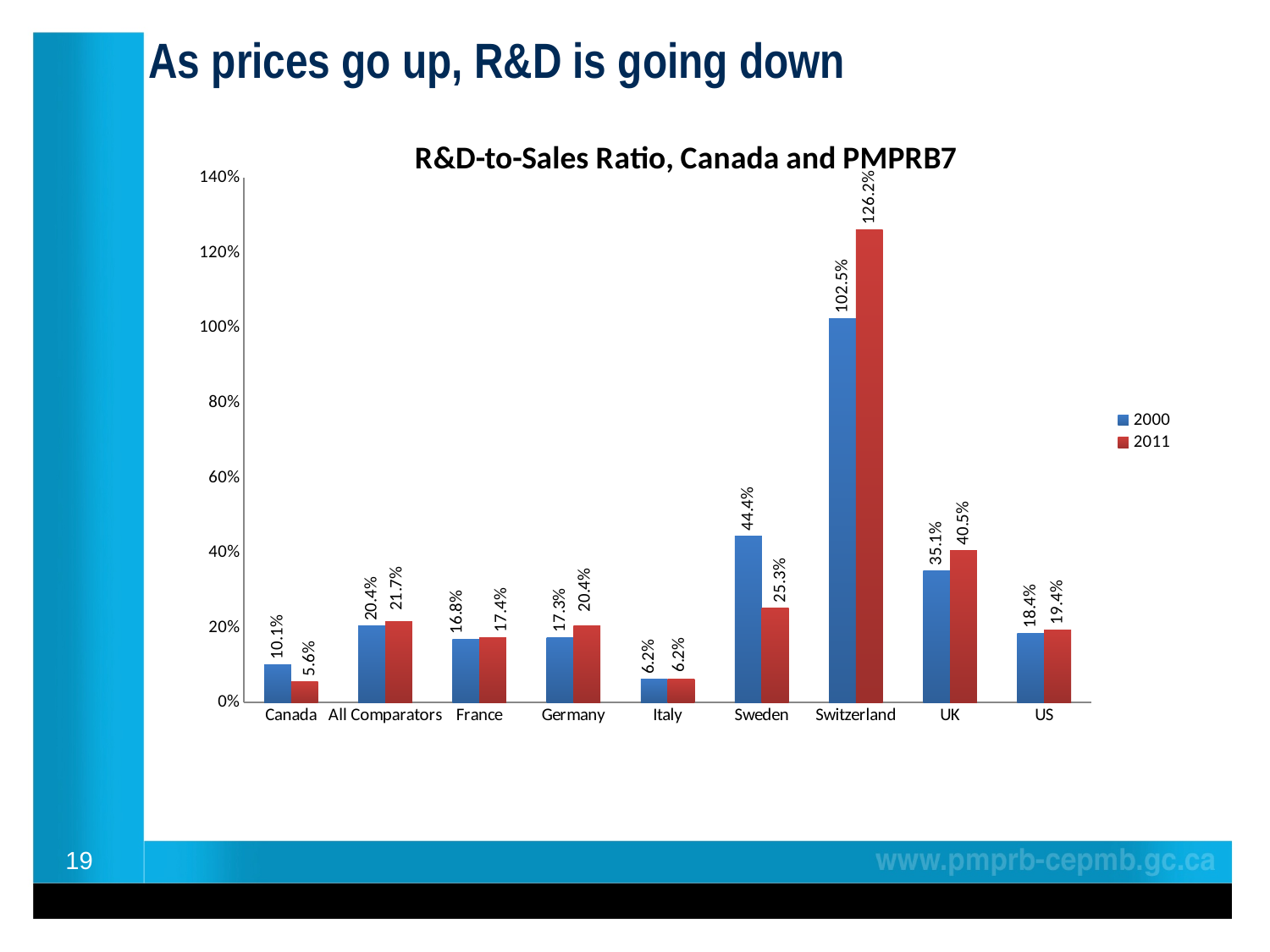
What is the title of the chart? R&D-to-Sales Ratio, Canada and PMPRB7 What is the difference between the UK's 2011 and 2000 R&D-to-Sales ratios? 5.4% What is the R&D-to-Sales ratio for Switzerland in 2000? 102.5% Which country has the highest R&D-to-Sales ratio in 2011? Switzerland Which category has the lowest R&D-to-Sales ratio in 2000? Italy What kind of chart is shown on the slide? Bar chart What is the R&D-to-Sales ratio for Canada in 2011? 5.6% What is the R&D-to-Sales ratio for Sweden in 2011? 25.3% Which is larger for Sweden: the 2000 value or the 2011 value? 2000 How many categories are shown on the x axis? 9 Is the 2011 value for Switzerland greater or less than 120%? greater How many series does the legend list? 2